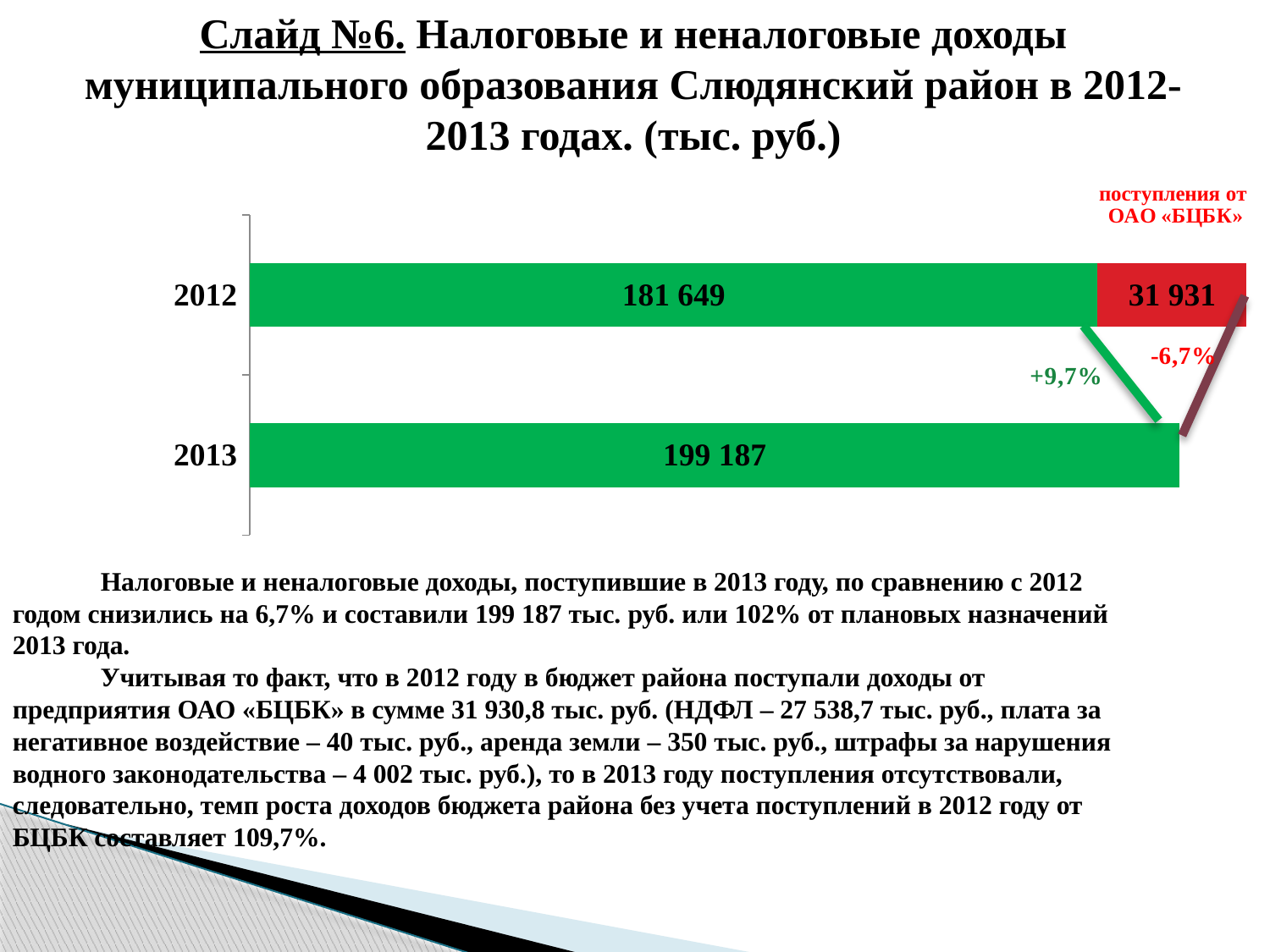
What is the value of the green bar for 2013? 199 187 What is the total of the stacked bar for 2012? 213 580 What is the difference between the green value for 2013 and the green value for 2012? 17 538 Which year has the larger green segment, 2012 or 2013? 2013 What percentage change is written next to the dark red arrow between 2012 and 2013? -6,7% What type of chart is shown on the slide? Bar chart What is the value of the green segment for 2012? 181 649 Which year has the larger total bar length? 2012 What percentage change is written next to the green arrow between 2012 and 2013? +9,7% What is the value of the red segment (поступления от ОАО «БЦБК») for 2012? 31 931 How many years (categories) are shown on the chart? 2